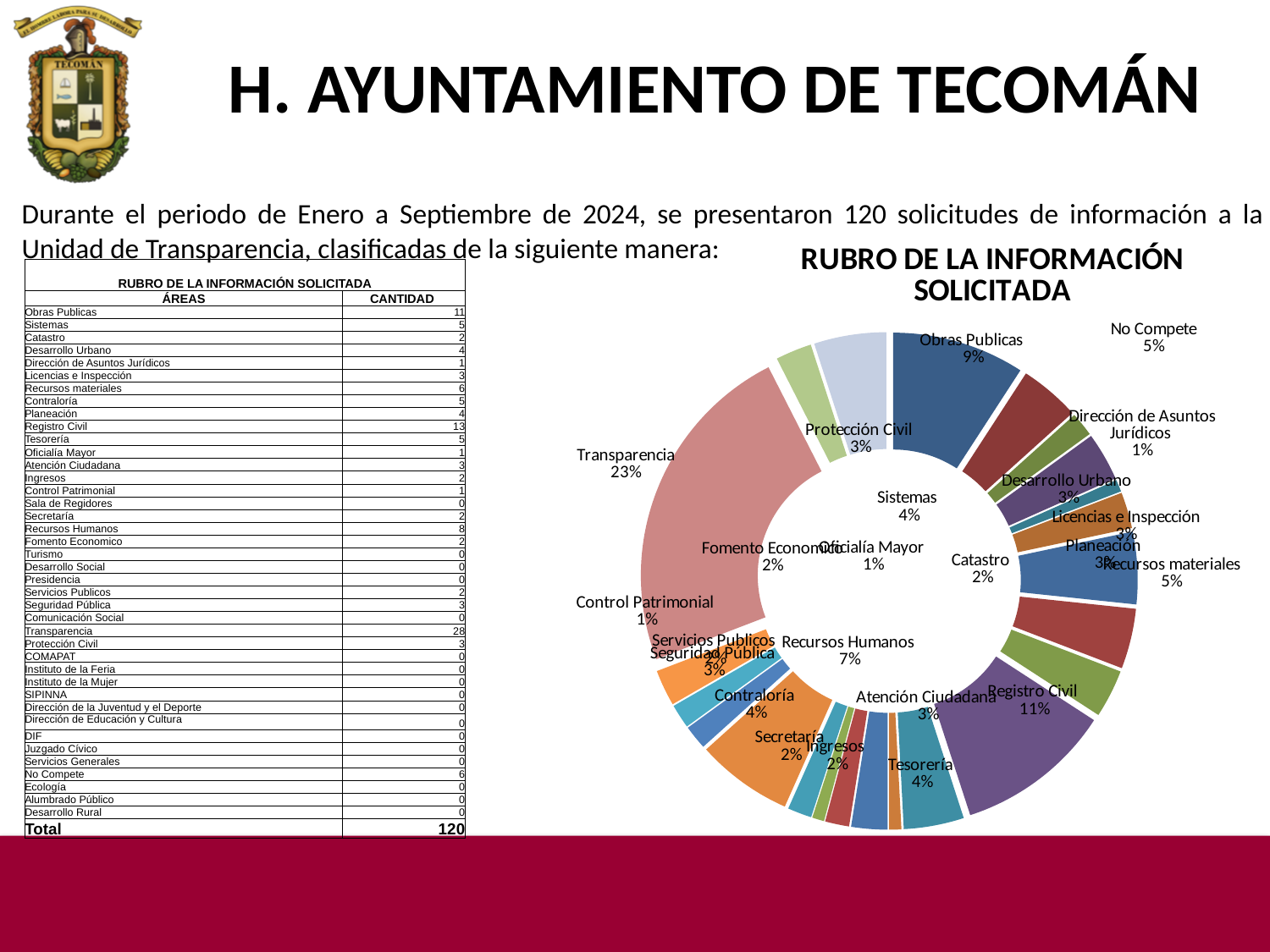
What percentage is shown for No Compete? 5% What share of the chart does Transparencia represent? 23% What is the difference in percentage points between Transparencia and Registro Civil? 12 What percentage is shown for Obras Publicas? 9% What percentage is shown for Tesorería? 4% Which has a larger share, Recursos Humanos or Sistemas? Recursos Humanos Which has a larger share, Registro Civil or Obras Publicas? Registro Civil Which area has the largest share in the chart? Transparencia What percentage is shown for Registro Civil? 11% What kind of chart is shown on the slide? doughnut chart What is the title of the chart? RUBRO DE LA INFORMACIÓN SOLICITADA What percentage is shown for Recursos Humanos? 7%